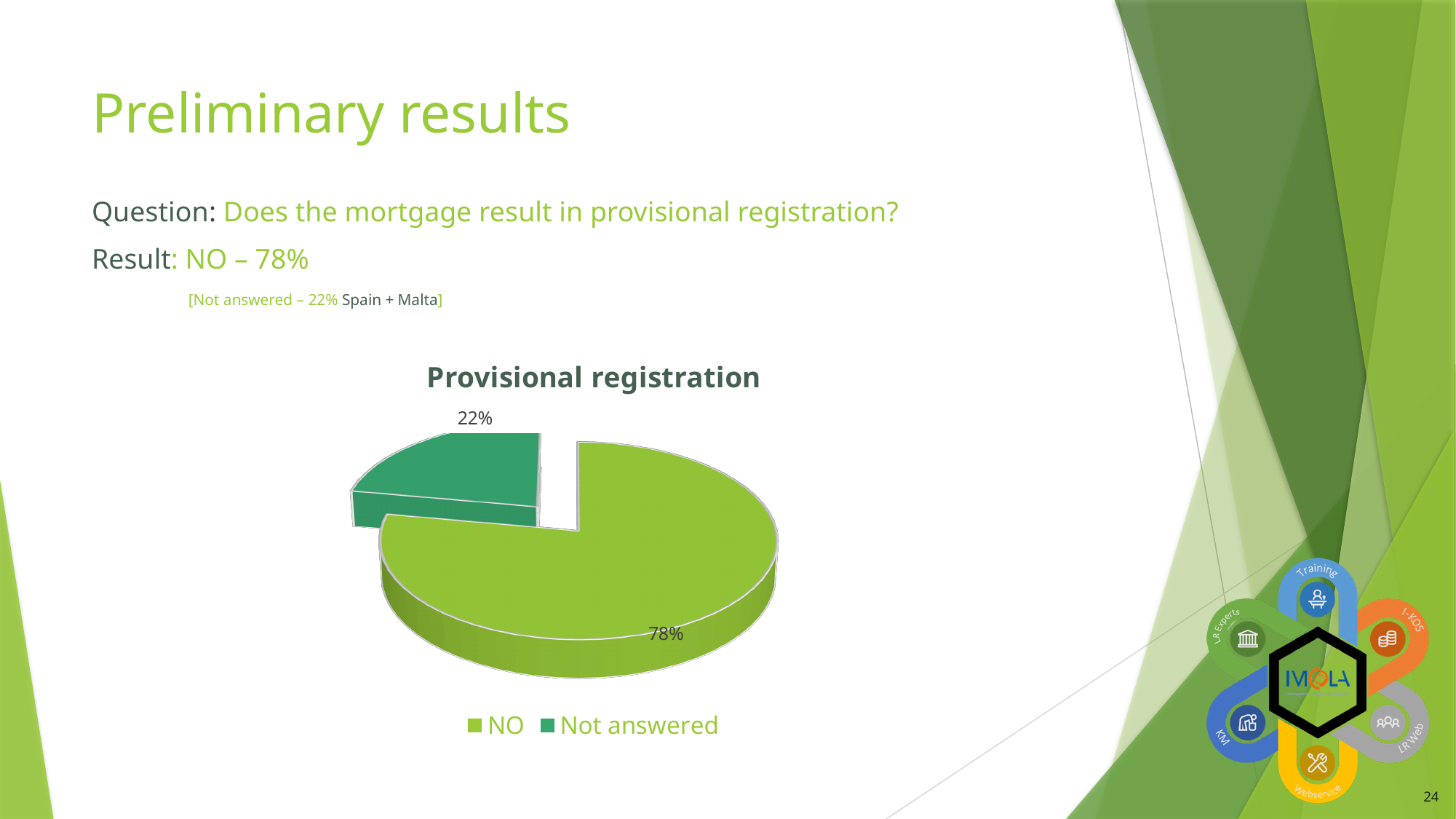
What is the title of the chart? Provisional registration Which slice of the pie is the smallest? Not answered Which slice of the pie is the largest? NO What percentage of the pie is labelled Not answered? 22% What share of the pie does the NO slice represent? 78% How many slices does the pie chart have? 2 How many entries does the legend list? 2 Which legend entry is shown in the darker green colour? Not answered What percentage of the pie is labelled NO? 78% What type of chart is shown on the slide? Pie chart What is the difference in percentage points between the NO slice and the Not answered slice? 56 Which is larger, the NO slice or the Not answered slice? NO